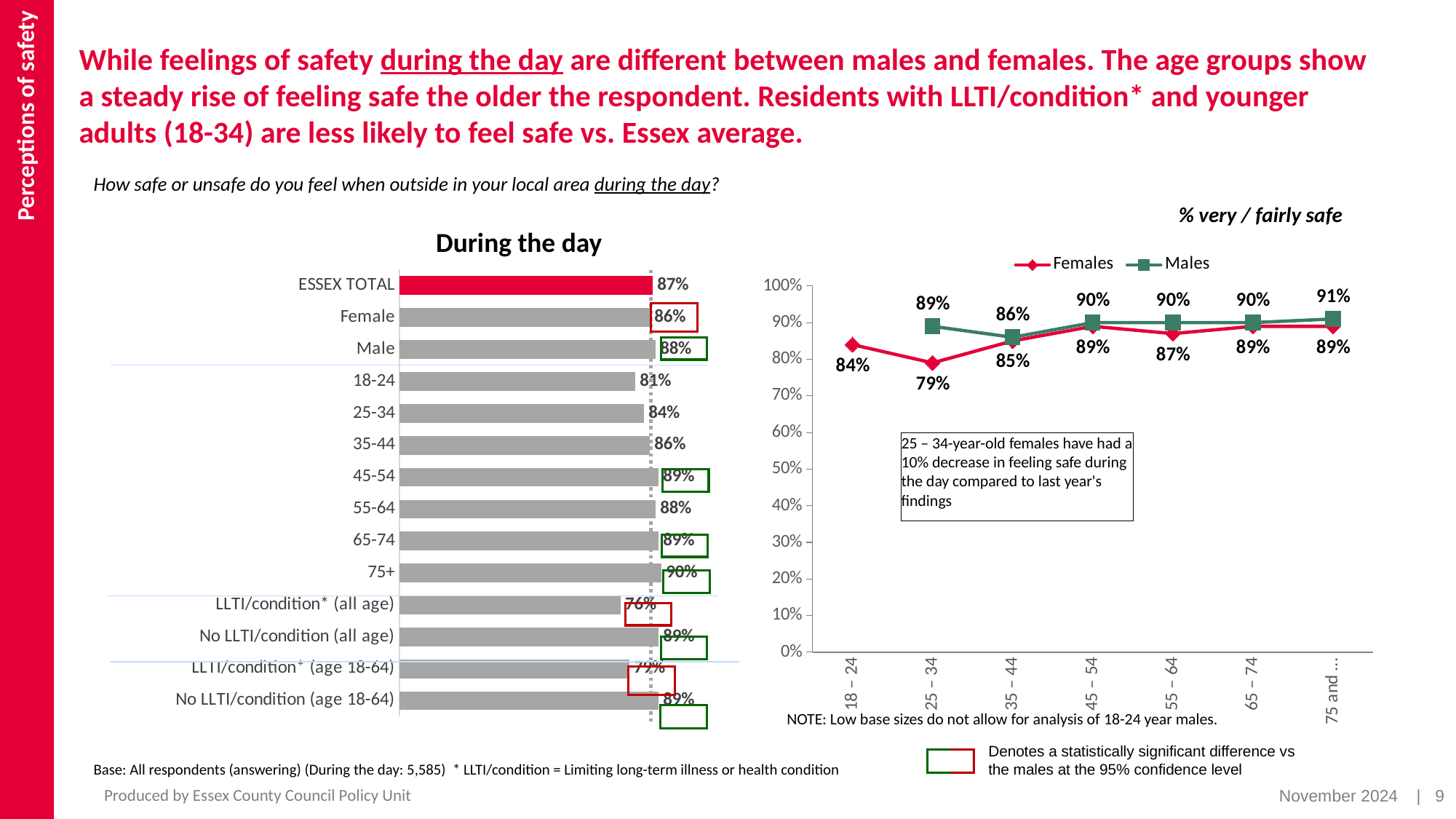
In the line chart on the right, which is larger for the 35 – 44 age group, Females or Males? Males In the 'During the day' bar chart, which category has the lowest value? LLTI/condition* (all age) What kind of chart is the 'During the day' chart on the left? Bar chart In the line chart on the right, what is the difference between Males and Females for the 25 – 34 age group? 10 percentage points In the 'During the day' bar chart, what is the value for LLTI/condition* (all age)? 76% In the line chart on the right, what is the value for Females aged 25 – 34? 79% In the 'During the day' bar chart, what is the difference between the Male and Female values? 2 percentage points How many series does the legend of the line chart on the right list? 2 In the line chart on the right, which age group has the lowest value for Females? 25 – 34 In the line chart on the right, what is the value for Males aged 75 and over? 91% In the 'During the day' bar chart, which age group has the highest value? 75+ In the 'During the day' bar chart, what is the value for ESSEX TOTAL? 87%